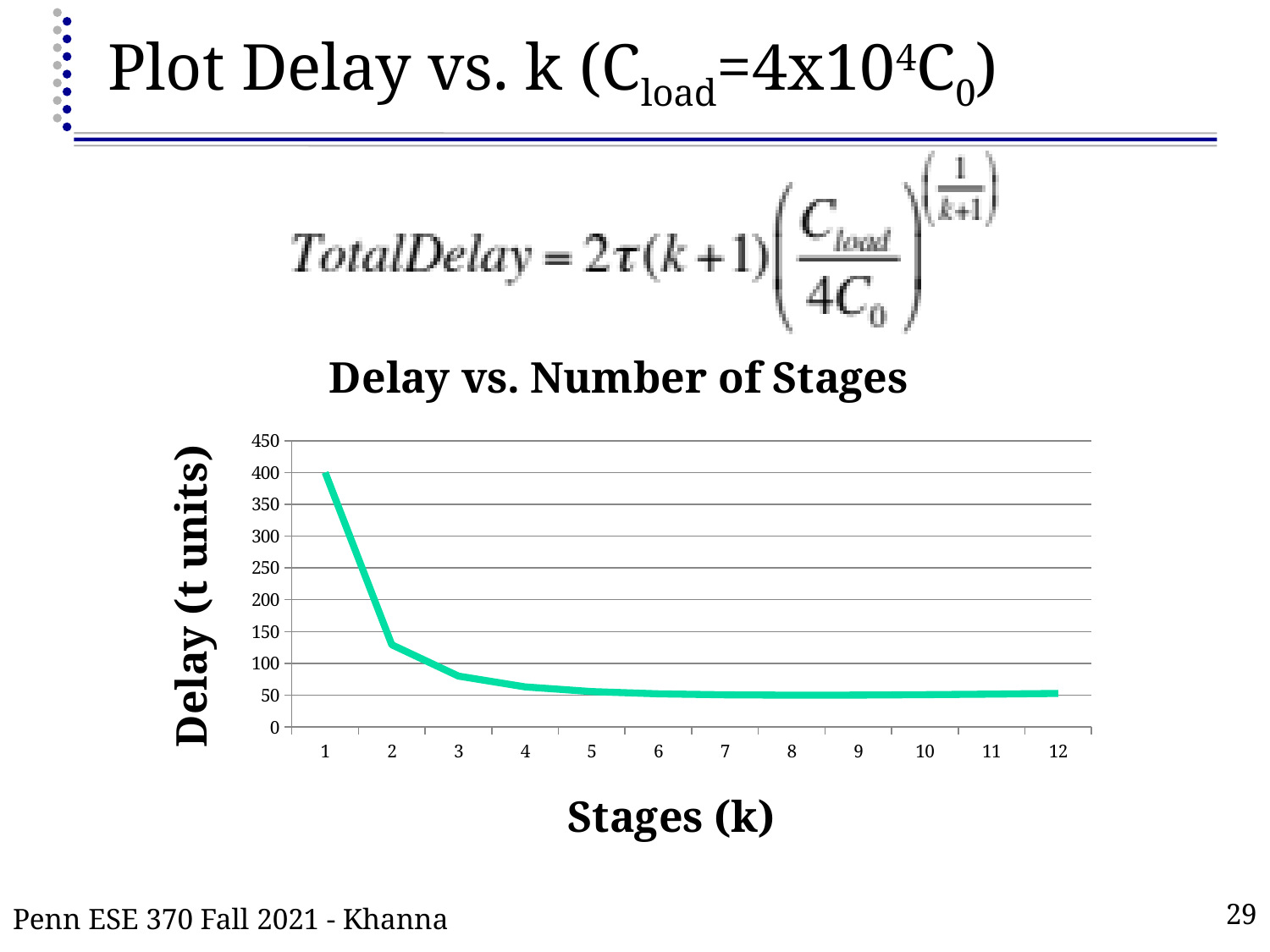
Is the delay at k=1 greater or less than 350? greater At which number of stages k is the delay highest? 1 Is the delay at k=2 greater or less than 150? less What is the label of the x axis of the chart? Stages (k) How many stage values (k) are plotted along the x axis? 12 Is the delay at k=3 greater or less than 100? less Which has the larger delay, k=1 or k=2? k=1 What is the title of the chart? Delay vs. Number of Stages What kind of chart is shown on the slide? line chart Which has the larger delay, k=2 or k=5? k=2 Does the delay rise or fall as the number of stages k increases? fall